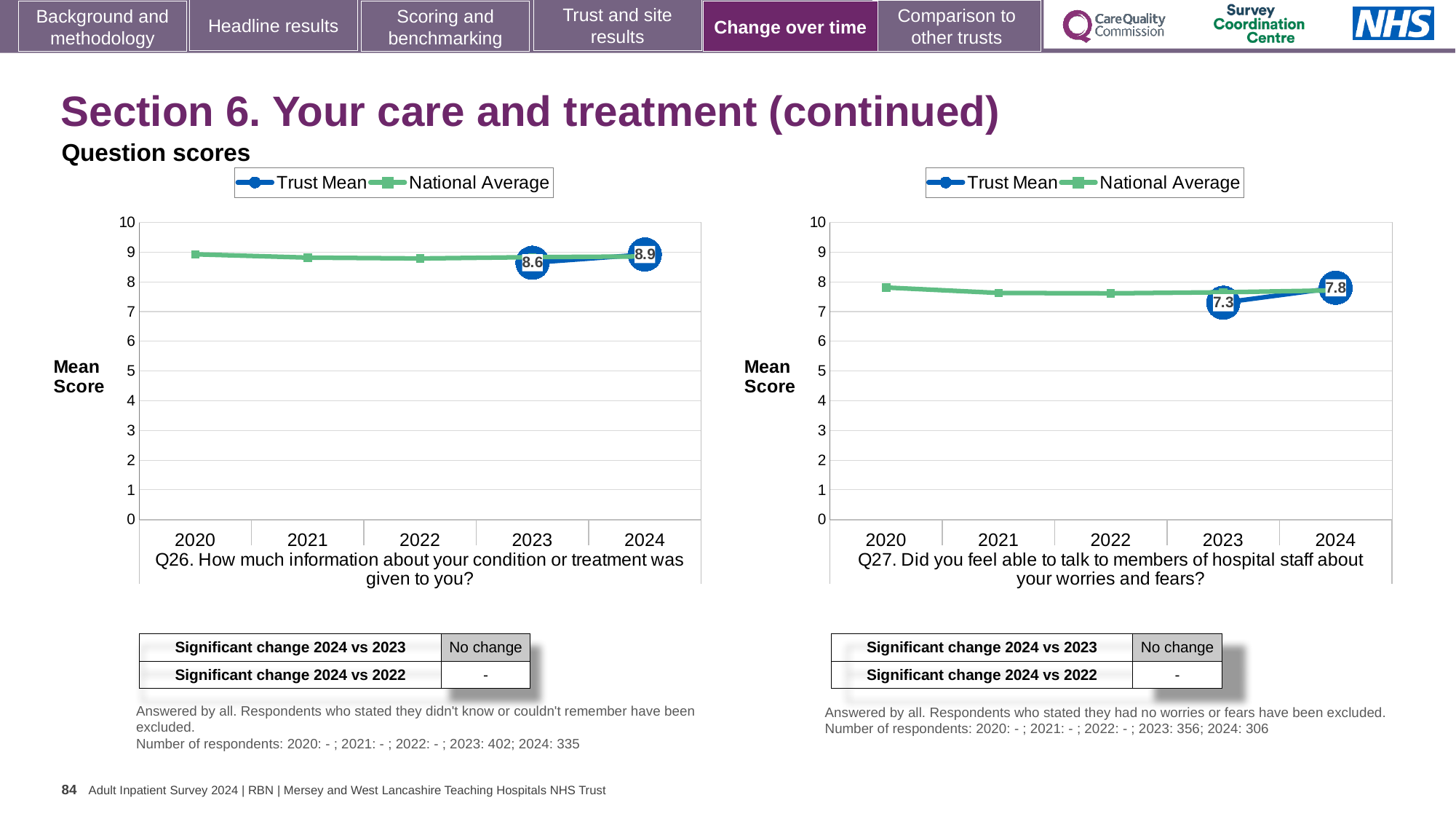
On the Q27 chart (right), what is the Trust Mean score for 2023? 7.3 On the Q27 chart (right), is the National Average for 2020 greater or less than 7? greater On the Q26 chart (left), is the National Average for 2021 greater or less than 8? greater On the Q27 chart (right), did the Trust Mean rise or fall from 2023 to 2024? rise On the Q26 chart (left), what is the Trust Mean score for 2023? 8.6 On the Q27 chart (right), what is the Trust Mean score for 2024? 7.8 How many series does the legend of the Q26 chart (left) list? 2 On the Q26 chart (left), which year has the higher Trust Mean, 2023 or 2024? 2024 On the Q26 chart (left), by how much did the Trust Mean change from 2023 to 2024? 0.3 On the Q26 chart (left), what is the Trust Mean score for 2024? 8.9 What type of chart is the Q27 chart (right)? line chart On the Q27 chart (right), what is the difference between the Trust Mean in 2024 and in 2023? 0.5